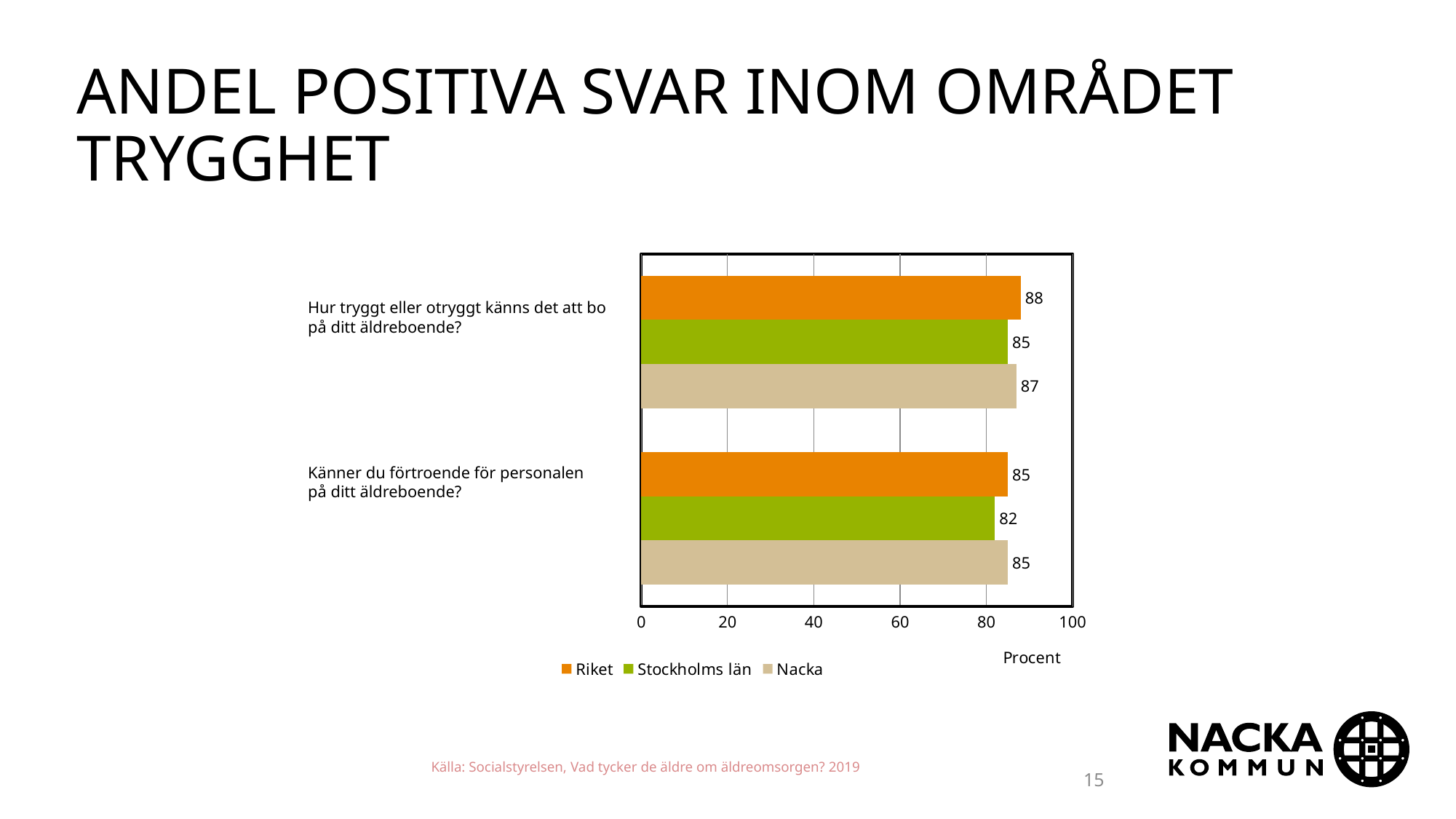
What is the difference between the Riket and Stockholms län values on the question "Hur tryggt eller otryggt känns det att bo på ditt äldreboende?"? 3 What is the value for Riket on the question "Hur tryggt eller otryggt känns det att bo på ditt äldreboende?"? 88 Which series has the highest value on the question "Hur tryggt eller otryggt känns det att bo på ditt äldreboende?"? Riket Which series has the lowest value on the question "Känner du förtroende för personalen på ditt äldreboende?"? Stockholms län What is the difference between the Nacka and Stockholms län values on the question "Känner du förtroende för personalen på ditt äldreboende?"? 3 What kind of chart is shown on the slide? Bar chart How many series does the legend list? 3 What is the value for Nacka on the question "Hur tryggt eller otryggt känns det att bo på ditt äldreboende?"? 87 What is the value for Stockholms län on the question "Känner du förtroende för personalen på ditt äldreboende?"? 82 What is the label on the horizontal axis of the chart? Procent What is the value for Nacka on the question "Känner du förtroende för personalen på ditt äldreboende?"? 85 Which is larger: the Nacka value for "Hur tryggt eller otryggt känns det att bo på ditt äldreboende?" or the Nacka value for "Känner du förtroende för personalen på ditt äldreboende?"? Hur tryggt eller otryggt känns det att bo på ditt äldreboende?